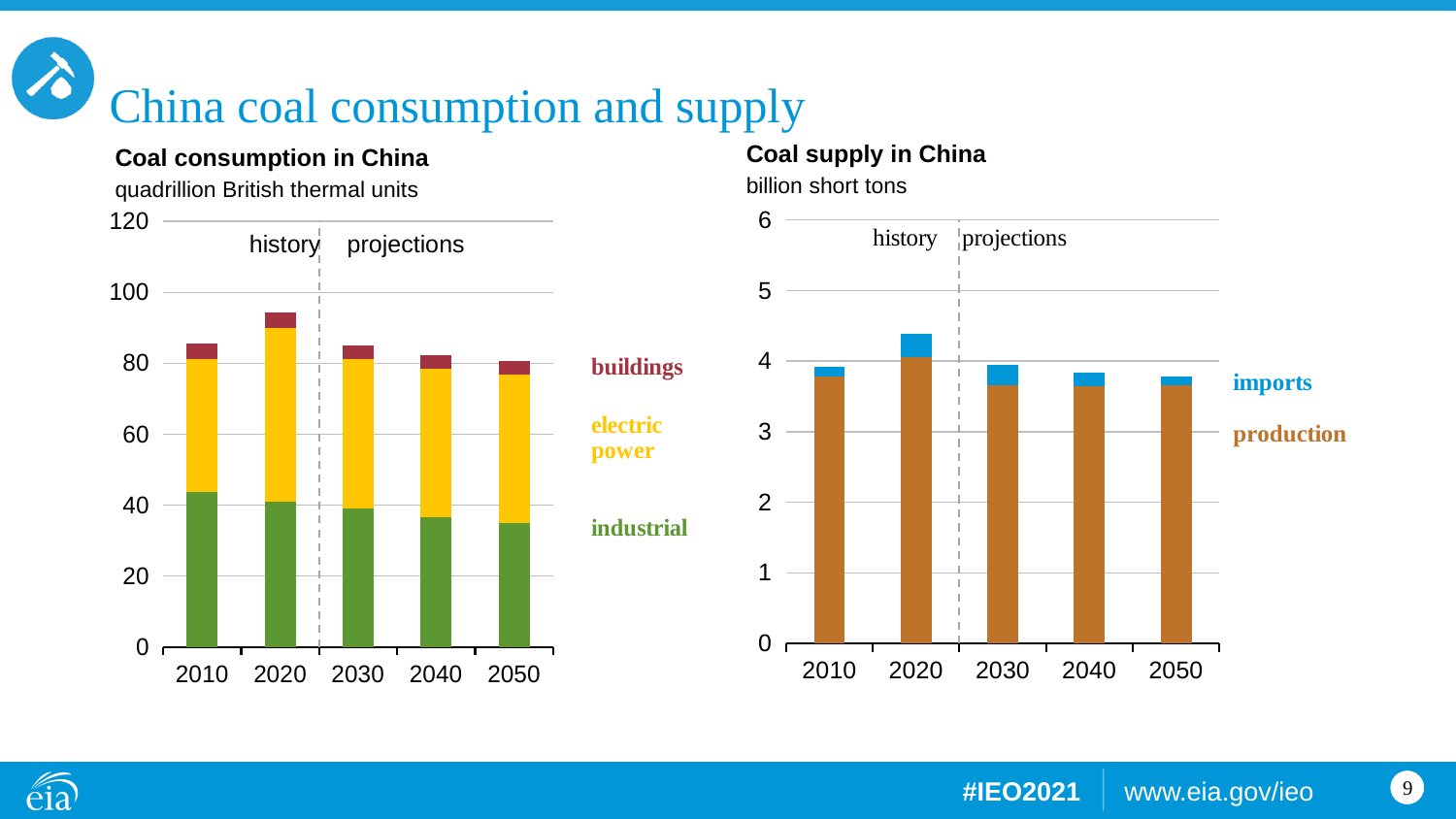
On the Coal consumption in China chart, is the total value for 2020 greater or less than 80? greater What unit is used on the Coal supply in China chart? billion short tons On the Coal consumption in China chart, is the industrial value for 2050 greater or less than 40? less On the Coal supply in China chart, which year has the highest total bar? 2020 On the Coal supply in China chart, how many series are shown in the legend? 2 On the Coal consumption in China chart, how many series are shown in the legend? 3 What kind of chart is the Coal consumption in China chart? stacked bar chart On the Coal supply in China chart, is the production value for 2010 greater or less than 4? less On the Coal consumption in China chart, how many years are plotted on the x axis? 5 On the Coal consumption in China chart, do the total values rise or fall from 2020 to 2050? fall On the Coal consumption in China chart, which year has the highest total bar? 2020